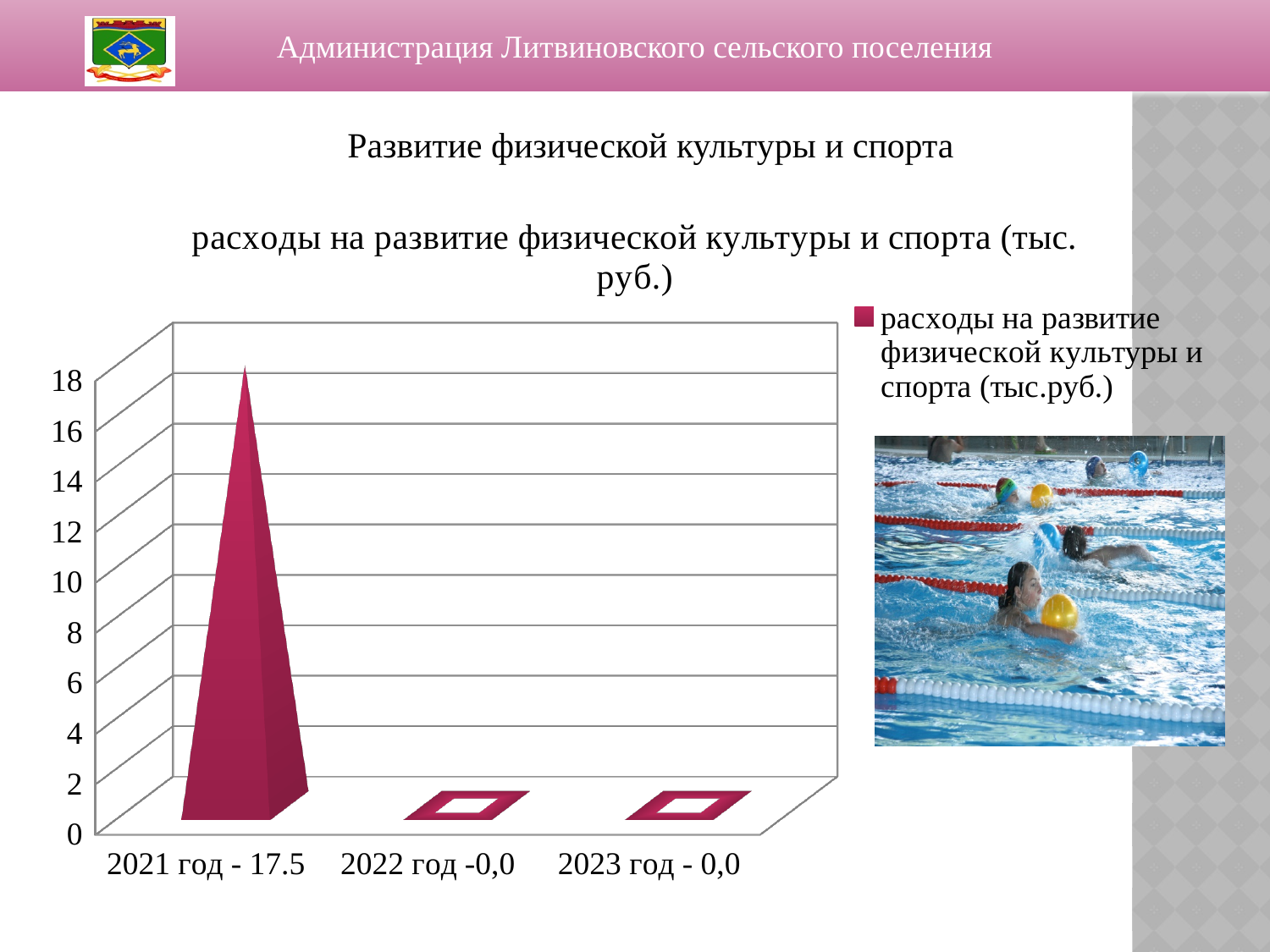
What type of chart is shown on the slide? bar chart Which year has the highest value in the chart? 2021 год How many series does the chart legend list? 1 What is the difference between the value for 2021 год and the value for 2023 год? 17.5 Do the values rise or fall from 2021 год to 2023 год along the x axis? fall What is the value for 2023 год according to the category label? 0,0 What is the title of the chart? расходы на развитие физической культуры и спорта (тыс. руб.) Is the value for 2021 год greater or less than 16? greater Which is larger, the value for 2021 год or the value for 2022 год? 2021 год What is the value for 2021 год according to the category label? 17.5 How many categories are shown on the x axis of the chart? 3 What is the value for 2022 год according to the category label? 0,0